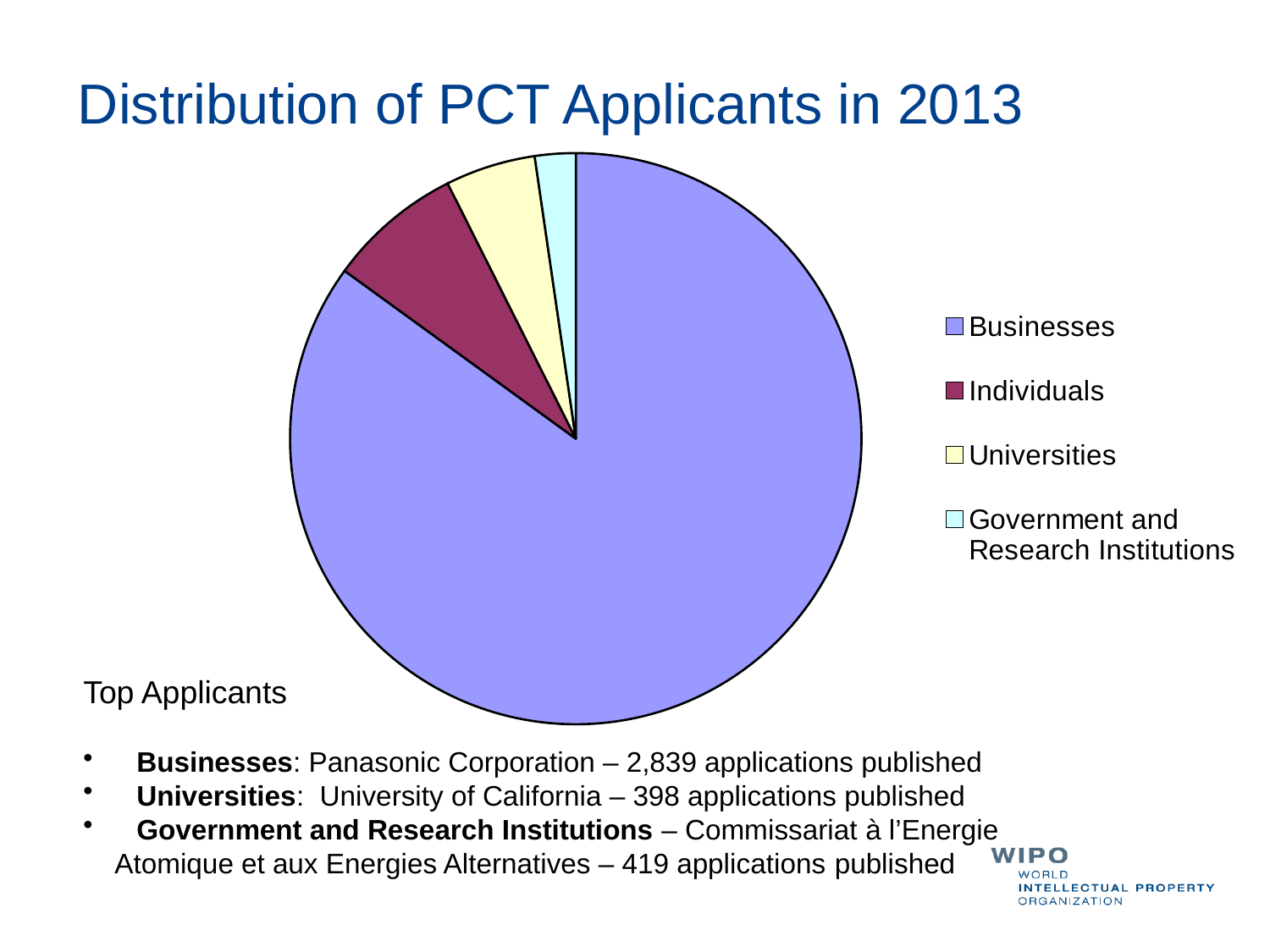
What kind of chart is shown on the slide? pie chart How many entries does the legend list? 4 Which slice is larger, Businesses or Individuals? Businesses What is the title of the slide's chart? Distribution of PCT Applicants in 2013 Which category has the smallest slice of the pie? Government and Research Institutions Which slice is larger, Individuals or Government and Research Institutions? Individuals Which category has the largest slice of the pie? Businesses Which slice is larger, Universities or Government and Research Institutions? Universities Which category is shown in the dark red slice? Individuals How many categories does the pie chart show? 4